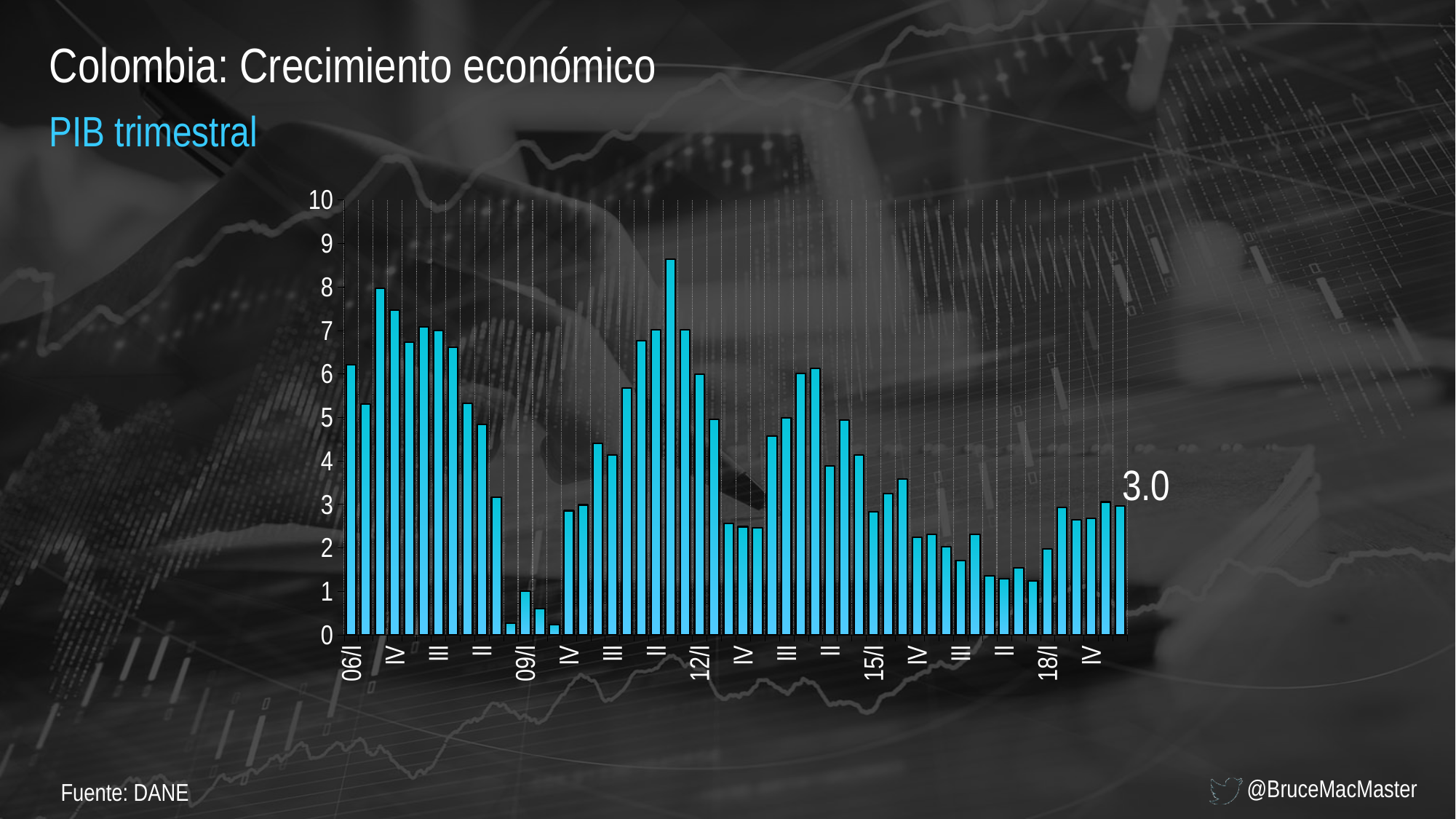
Which has the larger value, 12/I or 18/I? 12/I What is the first label on the horizontal axis? 06/I What is the highest value shown on the vertical axis? 10 Do the values generally rise or fall between 12/I and 18/I? fall Is the value for 09/I greater or less than 2? less Is the value of the tallest bar in the chart greater or less than 8? greater What value is printed as the data label on the last bar of the chart? 3.0 Is the value for 06/I greater or less than 5? greater What kind of chart is shown on the slide? bar chart Which has the larger value, 06/I or 09/I? 06/I